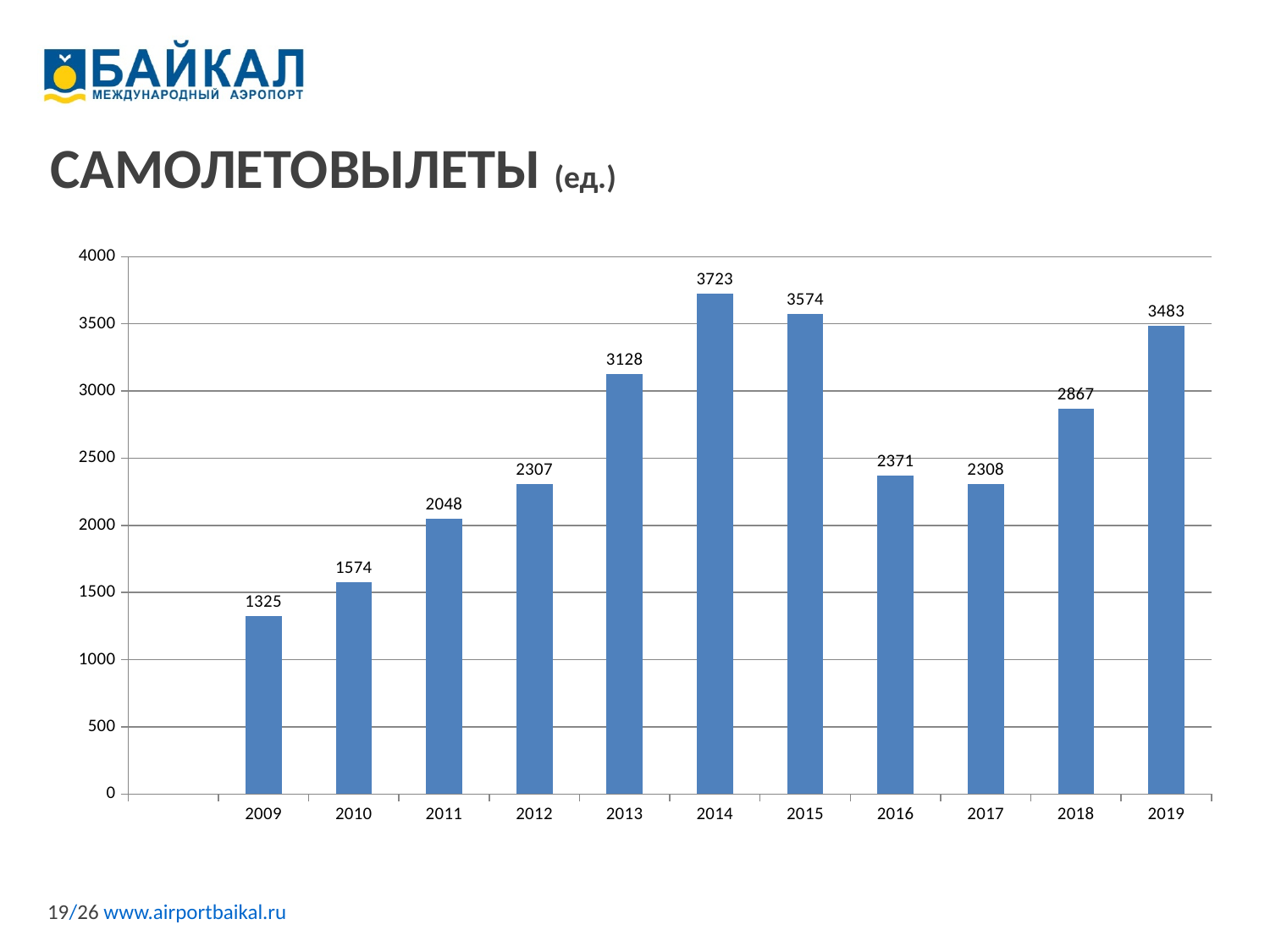
How many years are shown on the x axis? 11 Is the value for 2016 greater or less than 2500? less Do the values rise or fall from 2009 to 2014? rise What is the value for 2018? 2867 Which year has the highest value? 2014 What kind of chart is shown on the slide? bar chart What is the difference between the values for 2019 and 2018? 616 Which year has the lowest value? 2009 What is the difference between the values for 2014 and 2015? 149 What is the value for 2014? 3723 Which is larger, the value for 2013 or the value for 2019? 2019 What is the value for 2009? 1325